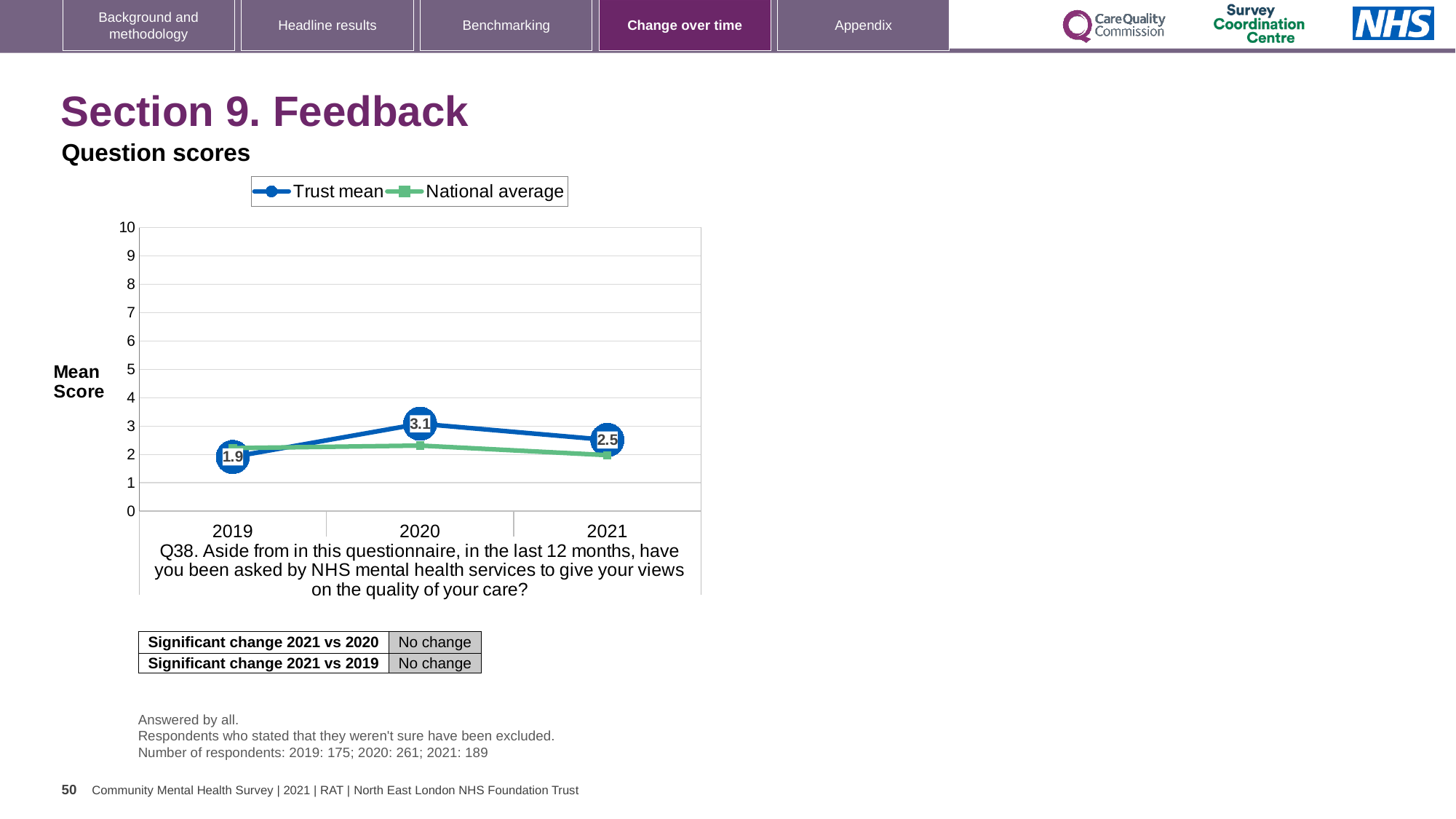
In which year is the Trust mean lowest? 2019 What kind of chart is shown on the slide? Line chart How many series does the legend list? 2 How many years are plotted on the x axis? 3 Which is larger, the Trust mean in 2021 or the Trust mean in 2019? 2021 What is the Trust mean score for 2021? 2.5 What is the Trust mean score for 2019? 1.9 By how much did the Trust mean increase from 2019 to 2020? 1.2 Is the National average for 2021 greater or less than 3? less What is the difference between the Trust mean in 2020 and in 2021? 0.6 In which year is the Trust mean highest? 2020 What is the Trust mean score for 2020? 3.1